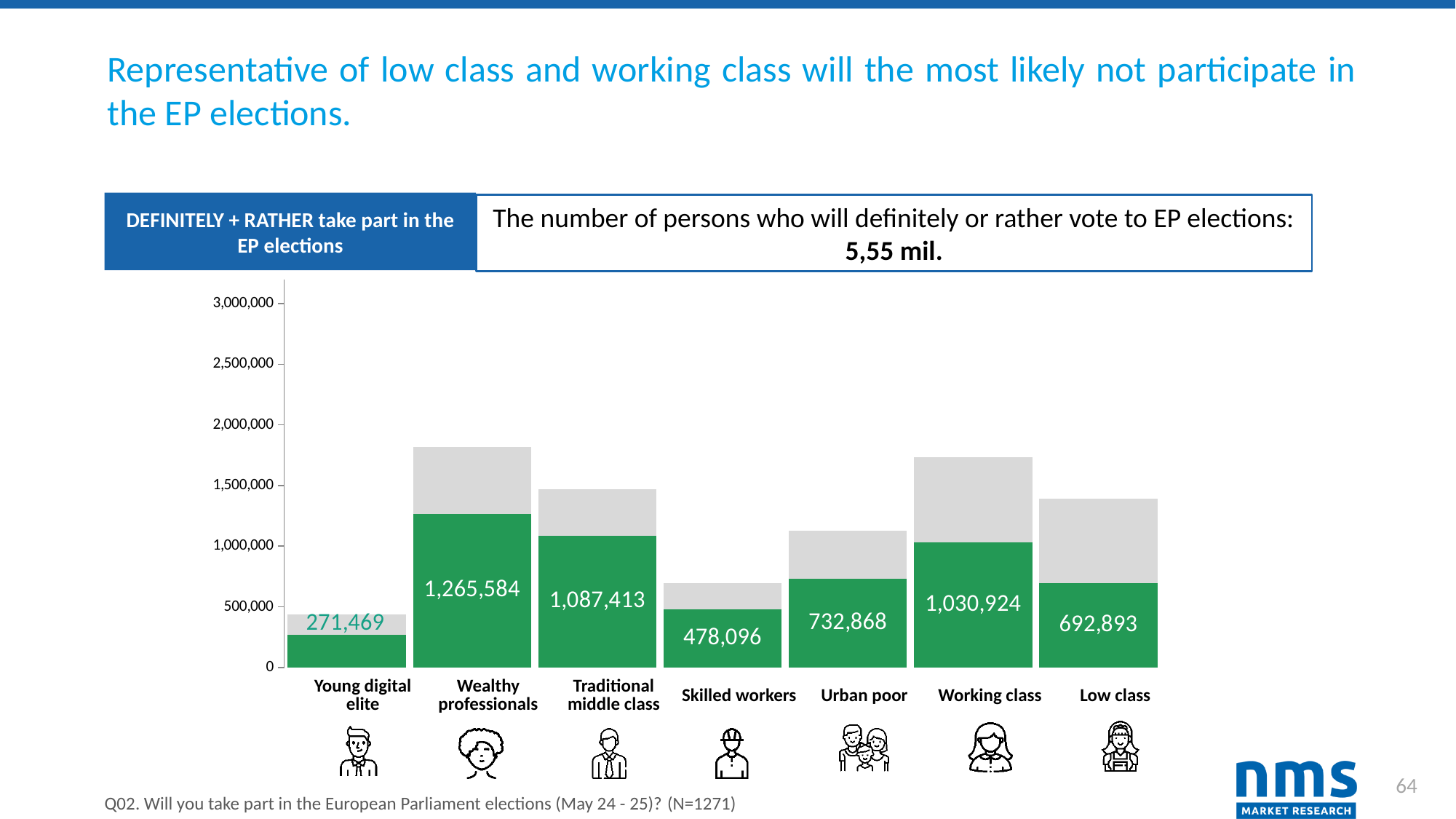
Which is larger: the number of Skilled workers or the number of Urban poor who will definitely or rather take part in the EP elections? Urban poor Is the full (grey) bar height for Skilled workers greater or less than 1,000,000? less What kind of chart is shown on the slide? Bar chart What is the difference between the Traditional middle class and Working class values for persons who will definitely or rather take part in the EP elections? 56,489 Is the full (grey) bar height for Working class greater or less than 1,500,000? greater How many segments are shown on the x axis of the chart? 7 Which segment has the lowest number of persons who will definitely or rather take part in the EP elections? Young digital elite Which segment has the highest number of persons who will definitely or rather take part in the EP elections? Wealthy professionals What is the number of persons in the Urban poor segment who will definitely or rather take part in the EP elections? 732,868 What is the number of persons in the Low class segment who will definitely or rather take part in the EP elections? 692,893 What is the number of persons in the Wealthy professionals segment who will definitely or rather take part in the EP elections? 1,265,584 According to the text box above the chart, what is the total number of persons who will definitely or rather vote in the EP elections? 5,55 mil.